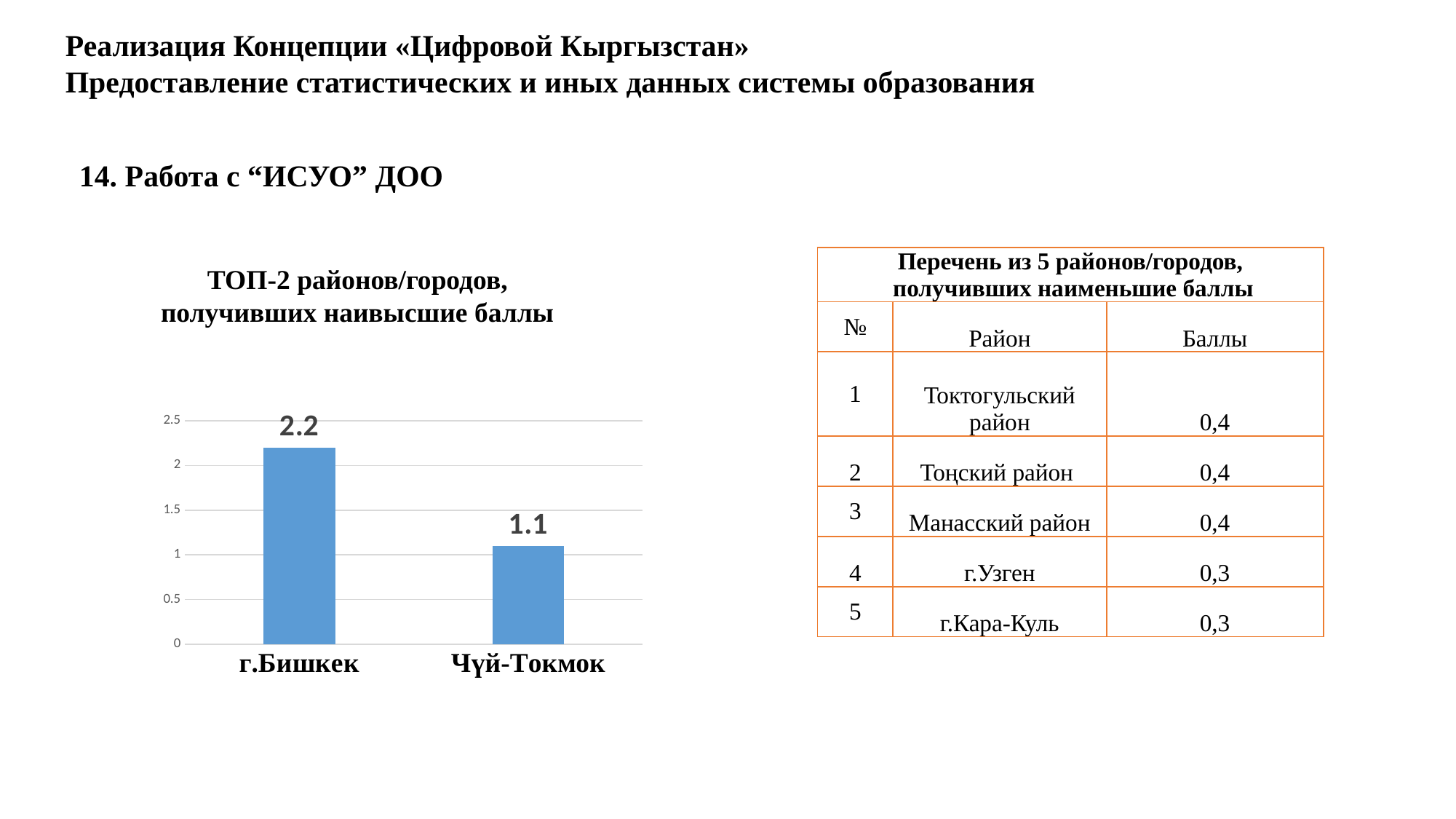
Which category has the highest value? г.Бишкек Is the value for Чүй-Токмок greater or less than 1.5? less What is the value for г.Бишкек? 2.2 What is the value for Чүй-Токмок? 1.1 What is the highest tick value shown on the vertical axis of the chart? 2.5 What is the difference between the values for г.Бишкек and Чүй-Токмок? 1.1 How many categories are shown in the chart? 2 Which category has the lowest value? Чүй-Токмок What kind of chart is shown on the slide? bar chart Is the value for г.Бишкек greater or less than 2? greater What is the title of the chart? ТОП-2 районов/городов, получивших наивысшие баллы Which is larger, the value for г.Бишкек or the value for Чүй-Токмок? г.Бишкек